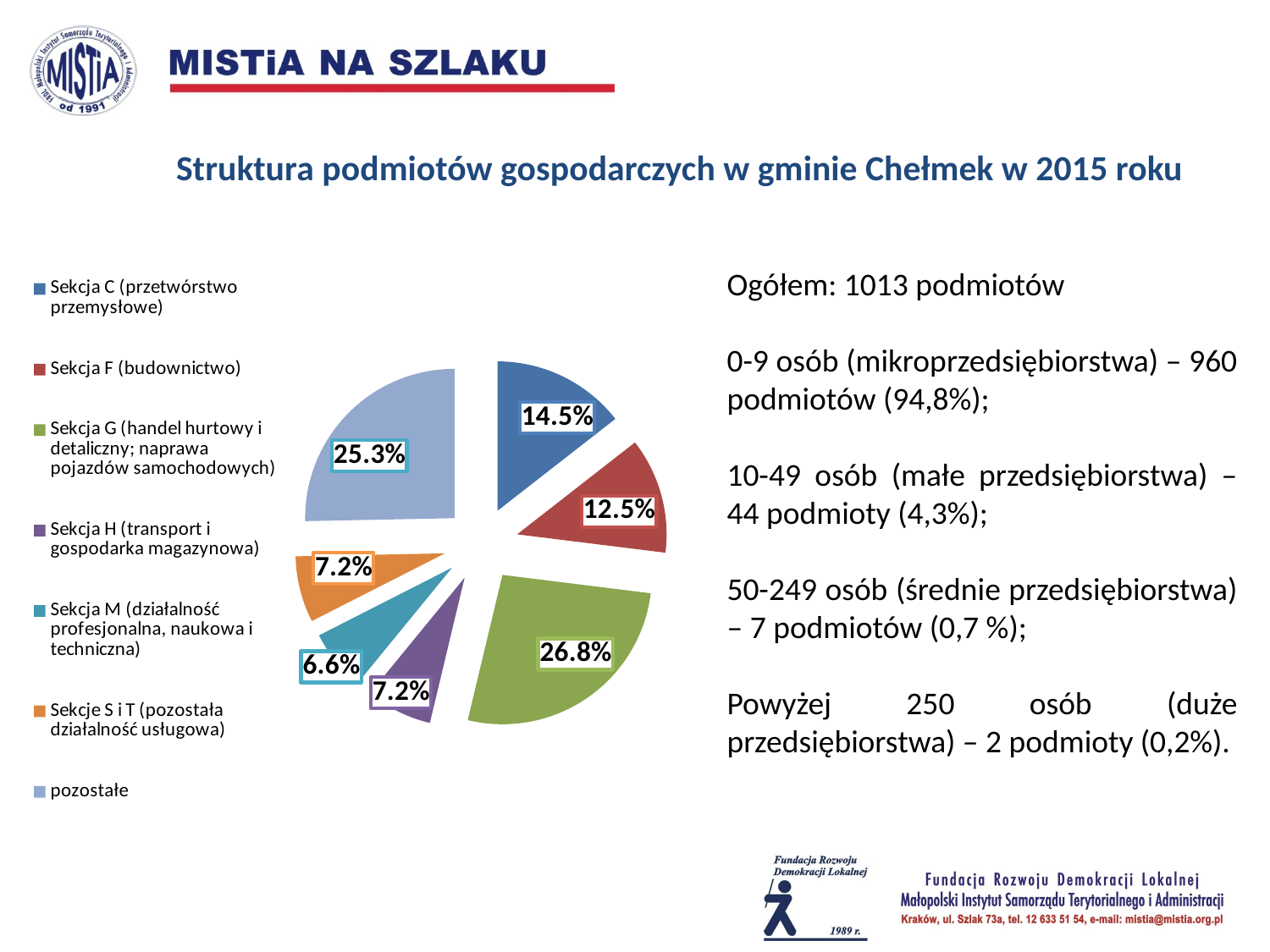
What is the title of the slide above the chart? Struktura podmiotów gospodarczych w gminie Chełmek w 2015 roku What is the value shown for Sekcja M (działalność profesjonalna, naukowa i techniczna)? 6.6% Which category has the smallest share of the pie? Sekcja M (działalność profesjonalna, naukowa i techniczna) What share of the pie does Sekcja G (handel hurtowy i detaliczny; naprawa pojazdów samochodowych) have? 26.8% What is the value shown for Sekcja C (przetwórstwo przemysłowe)? 14.5% What is the value shown for Sekcja F (budownictwo)? 12.5% What is the difference in percentage points between Sekcja G and Sekcja C? 12.3 How many slices does the pie chart have? 7 What is the value shown for the 'pozostałe' slice? 25.3% What type of chart is shown on the slide? pie chart Which category has the largest share of the pie? Sekcja G (handel hurtowy i detaliczny; naprawa pojazdów samochodowych) Which is larger: the share for Sekcja C (przetwórstwo przemysłowe) or for Sekcja F (budownictwo)? Sekcja C (przetwórstwo przemysłowe)